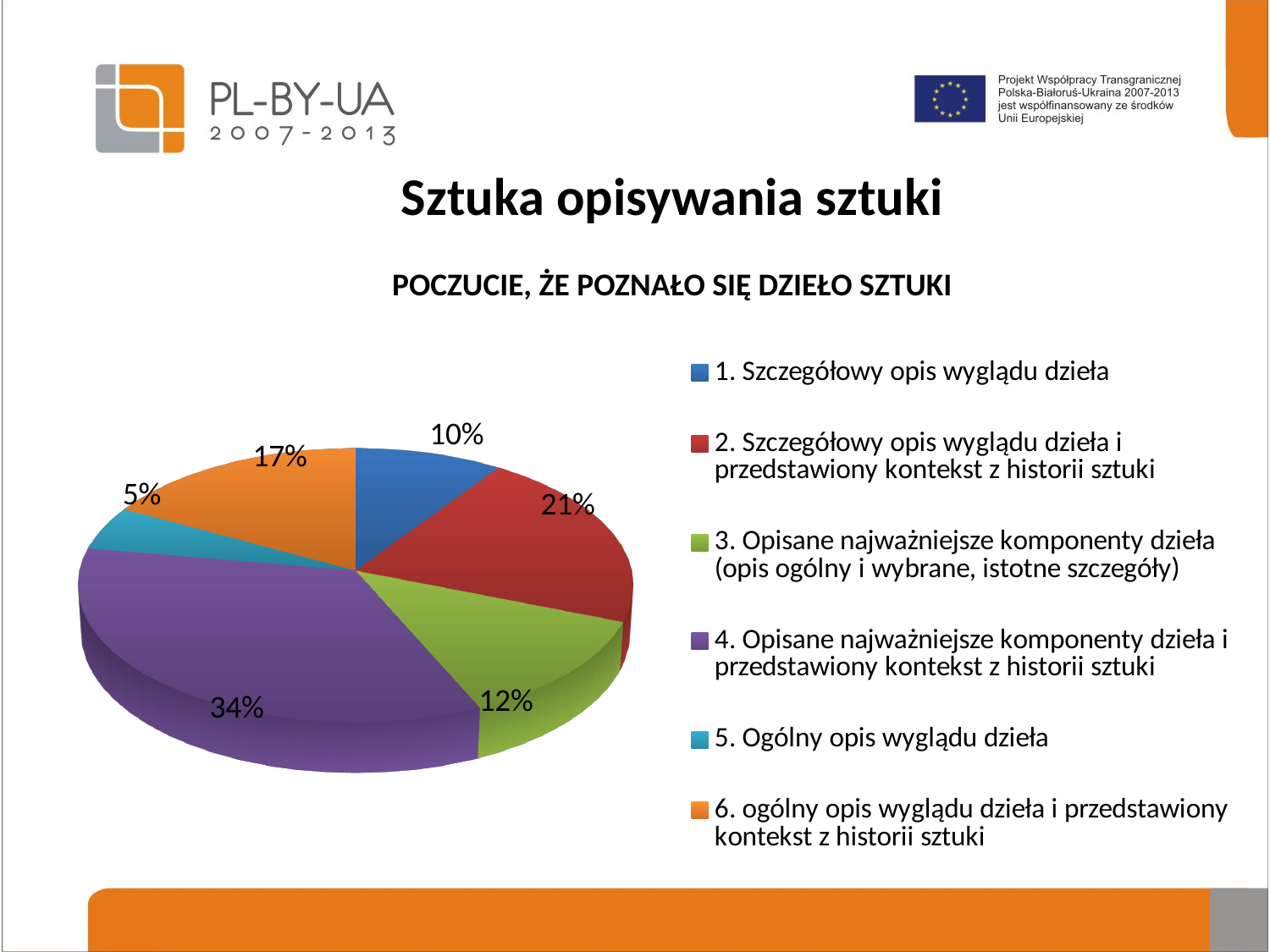
What is the value for "6. ogólny opis wyglądu dzieła i przedstawiony kontekst z historii sztuki"? 17% How many slices does the pie chart have? 6 What is the value for "5. Ogólny opis wyglądu dzieła"? 5% What kind of chart is shown on the slide? Pie chart What is the value for "2. Szczegółowy opis wyglądu dzieła i przedstawiony kontekst z historii sztuki"? 21% Which is larger: the share for "3. Opisane najważniejsze komponenty dzieła (opis ogólny i wybrane, istotne szczegóły)" or for "6. ogólny opis wyglądu dzieła i przedstawiony kontekst z historii sztuki"? 6. ogólny opis wyglądu dzieła i przedstawiony kontekst z historii sztuki What is the difference between the share for category 4 (34%) and category 2 (21%)? 13% Which category has the largest share of the pie? 4. Opisane najważniejsze komponenty dzieła i przedstawiony kontekst z historii sztuki Which category has the smallest share of the pie? 5. Ogólny opis wyglądu dzieła What is the title of the chart? POCZUCIE, ŻE POZNAŁO SIĘ DZIEŁO SZTUKI What is the value for "1. Szczegółowy opis wyglądu dzieła"? 10% What share of the pie does "4. Opisane najważniejsze komponenty dzieła i przedstawiony kontekst z historii sztuki" have? 34%